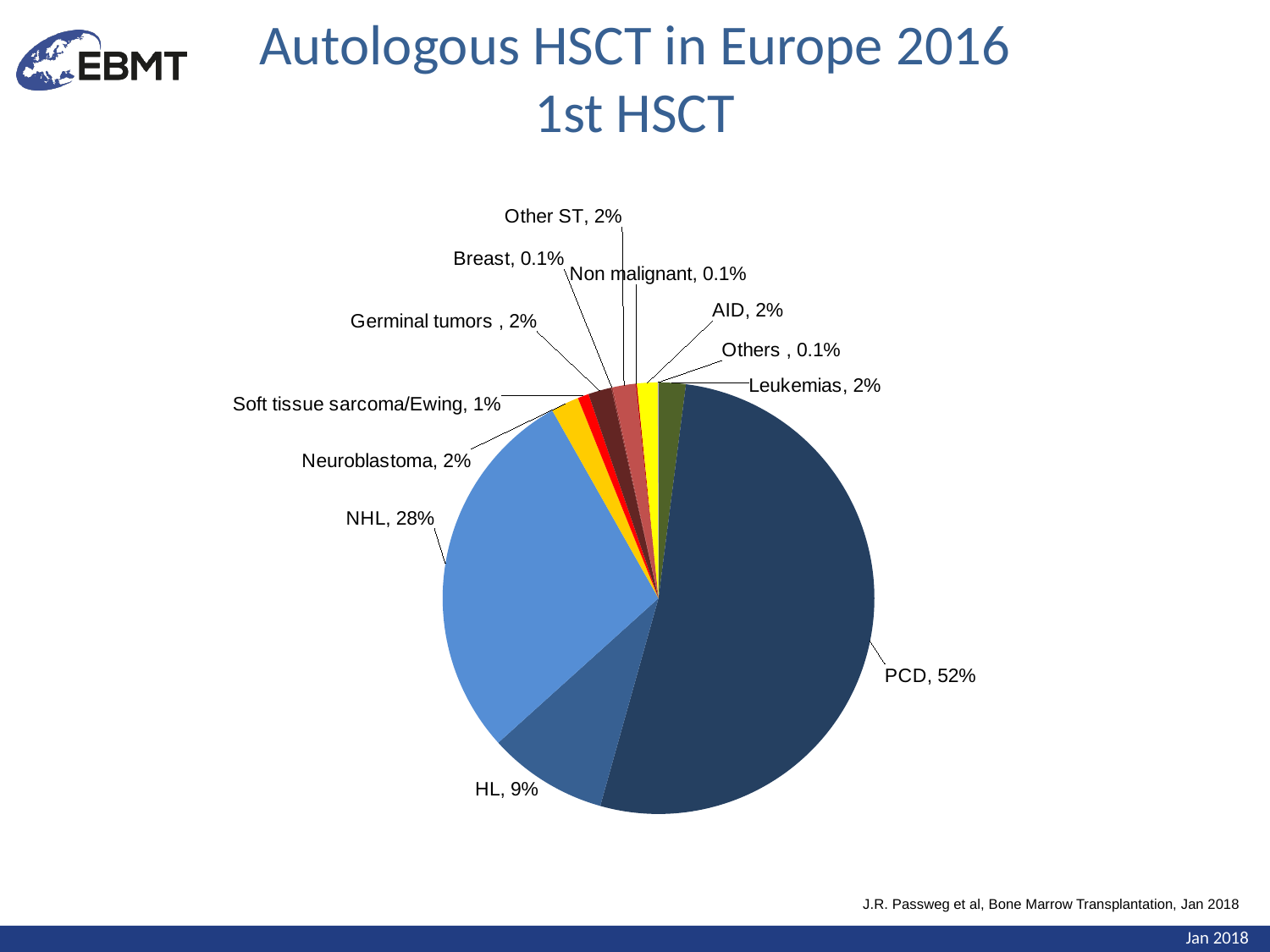
What kind of chart is shown on the slide? pie chart How many slices does the pie chart have? 12 What is the title of the chart on the slide? Autologous HSCT in Europe 2016 1st HSCT What is the value shown for NHL? 28% Which is larger, the slice for NHL or the slice for HL? NHL What is the value shown for Breast? 0.1% What is the value shown for Soft tissue sarcoma/Ewing? 1% What share of the pie does PCD account for? 52% What is the difference between the PCD share and the NHL share? 24% Which category has the largest slice of the pie? PCD What is the value shown for HL? 9% What is the difference between the NHL share and the HL share? 19%